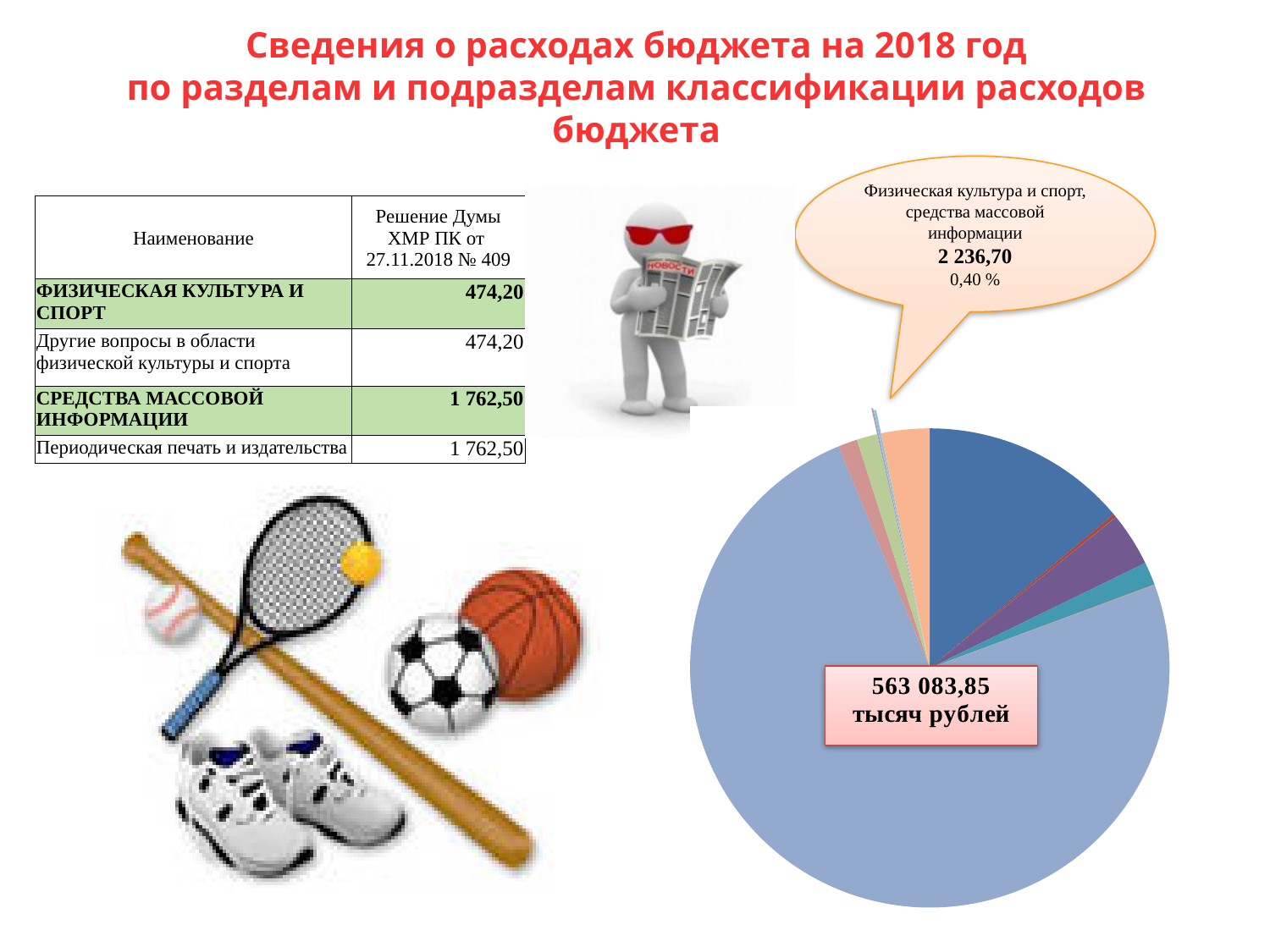
What kind of chart is shown on the right side of the slide? pie chart According to the callout on the pie chart, what is the value for Физическая культура и спорт, средства массовой информации? 2 236,70 Which is larger: the slice for Физическая культура и спорт, средства массовой информации or the large light-blue slice that fills most of the pie? the large light-blue slice Is the share of the slice for Физическая культура и спорт, средства массовой информации greater or less than 1 %? less What share of the pie does the slice for Физическая культура и спорт, средства массовой информации represent, according to the callout? 0,40 % What is the title of the slide containing the pie chart? Сведения о расходах бюджета на 2018 год по разделам и подразделам классификации расходов бюджета What total amount is printed on the pie chart? 563 083,85 тысяч рублей Does the pie chart display a legend? No